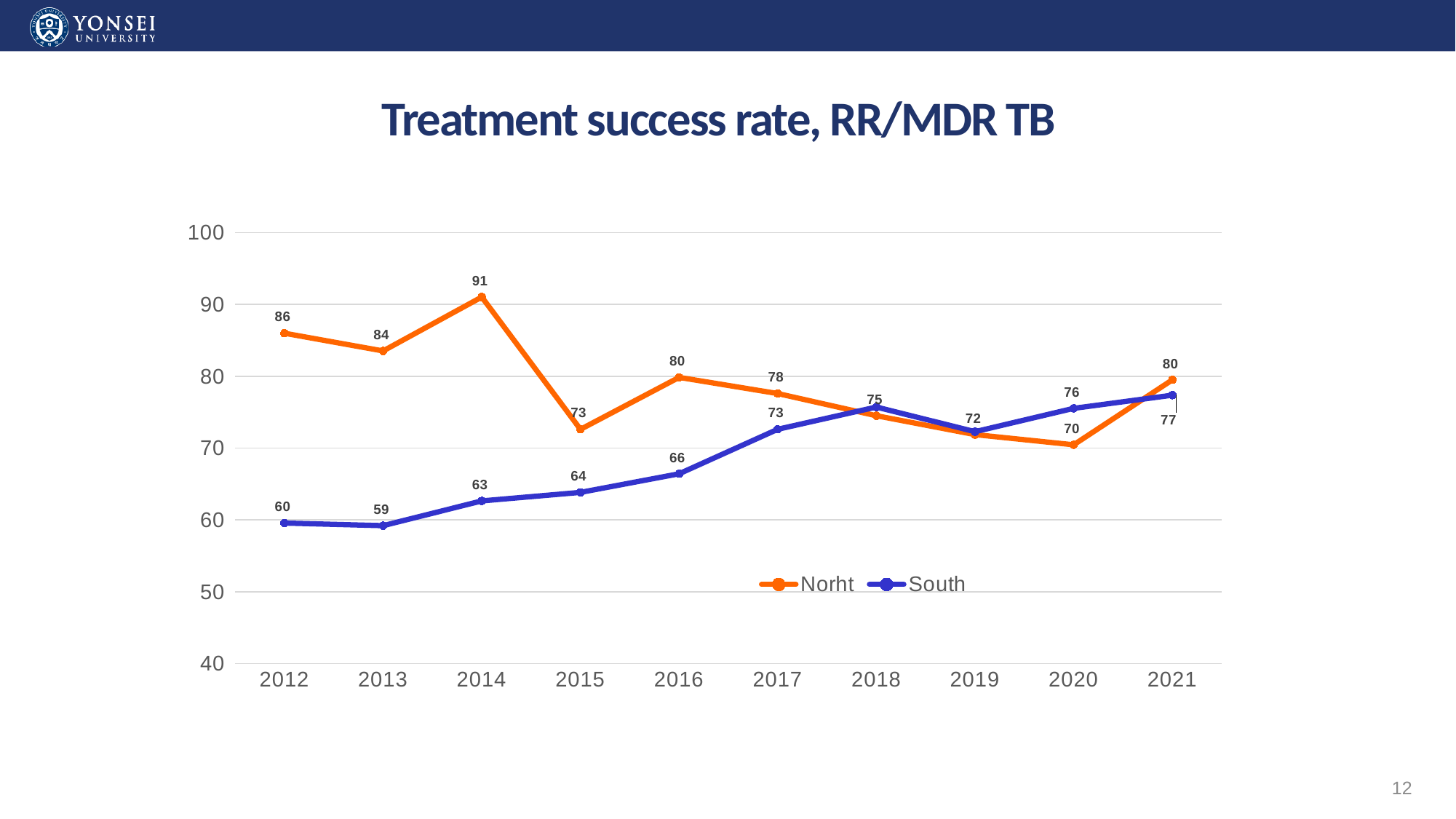
What is the value for Norht in 2014? 91 Which series has the larger value in 2016, Norht or South? Norht Which series has the larger value in 2020, Norht or South? South What is the value for South in 2013? 59 In which year is the Norht series highest? 2014 What kind of chart is shown on the slide? line chart Is the value for South in 2018 greater or less than 70? greater What is the value for Norht in 2020? 70 How many years are shown on the x axis? 10 What is the difference between Norht and South in 2012? 26 What is the value for South in 2021? 77 In which year is the South series lowest? 2013